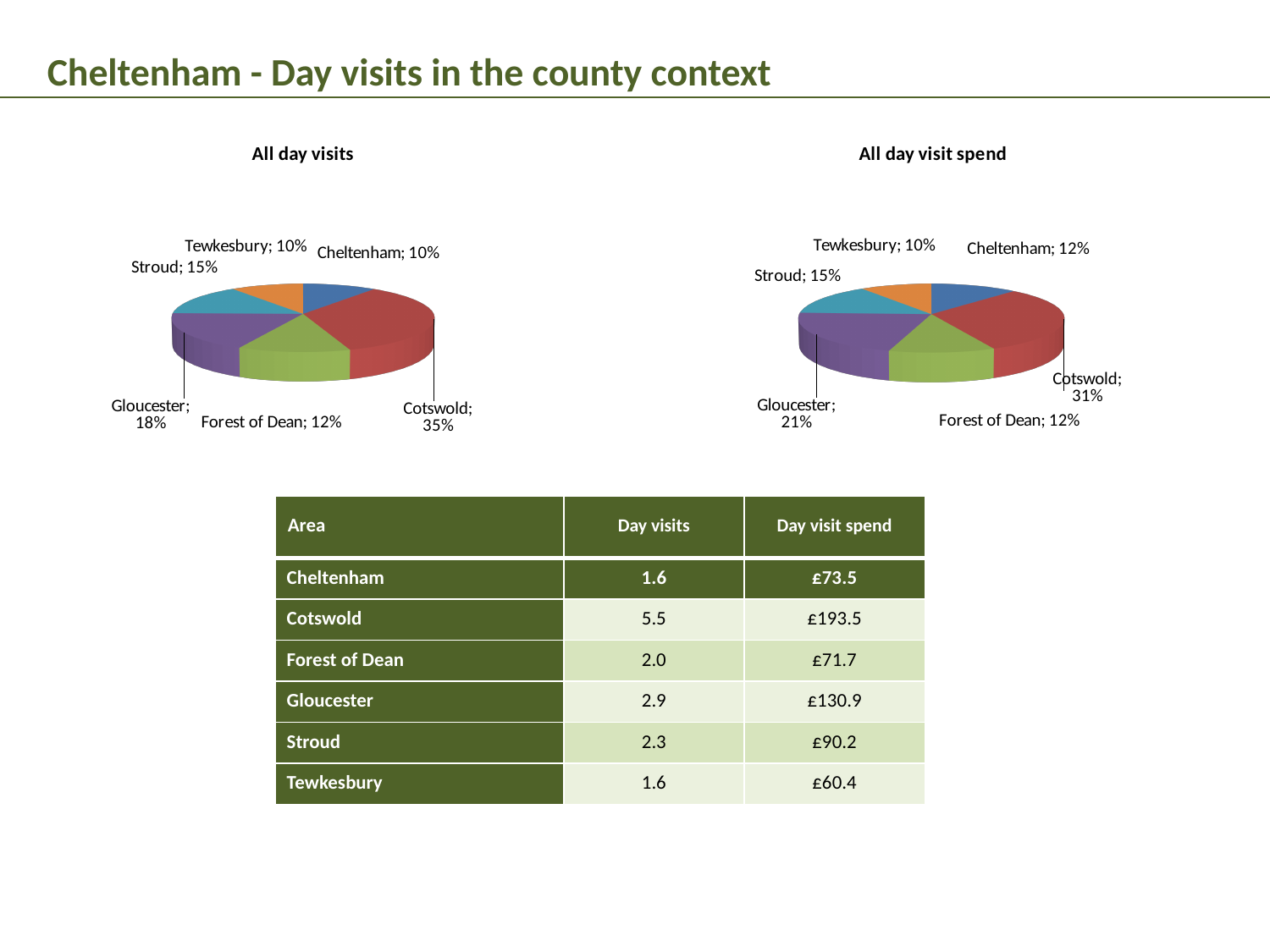
In the 'All day visit spend' pie chart, what is the difference between the Cotswold share and the Forest of Dean share? 19% In the 'All day visits' pie chart, which area has the largest share? Cotswold How many slices does the 'All day visits' pie chart have? 6 What is the title of the pie chart on the left of the slide? All day visits In the 'All day visit spend' pie chart, what share does Gloucester have? 21% In the 'All day visit spend' pie chart, which area has the smallest share? Tewkesbury In the 'All day visit spend' pie chart, what share does Cheltenham have? 12% In the 'All day visits' pie chart, what share does Cotswold have? 35% What kind of chart is the 'All day visit spend' chart? Pie chart In the 'All day visit spend' pie chart, which is larger, the share for Stroud or the share for Cheltenham? Stroud In the 'All day visits' pie chart, what is the difference between the Cotswold share and the Gloucester share? 17%